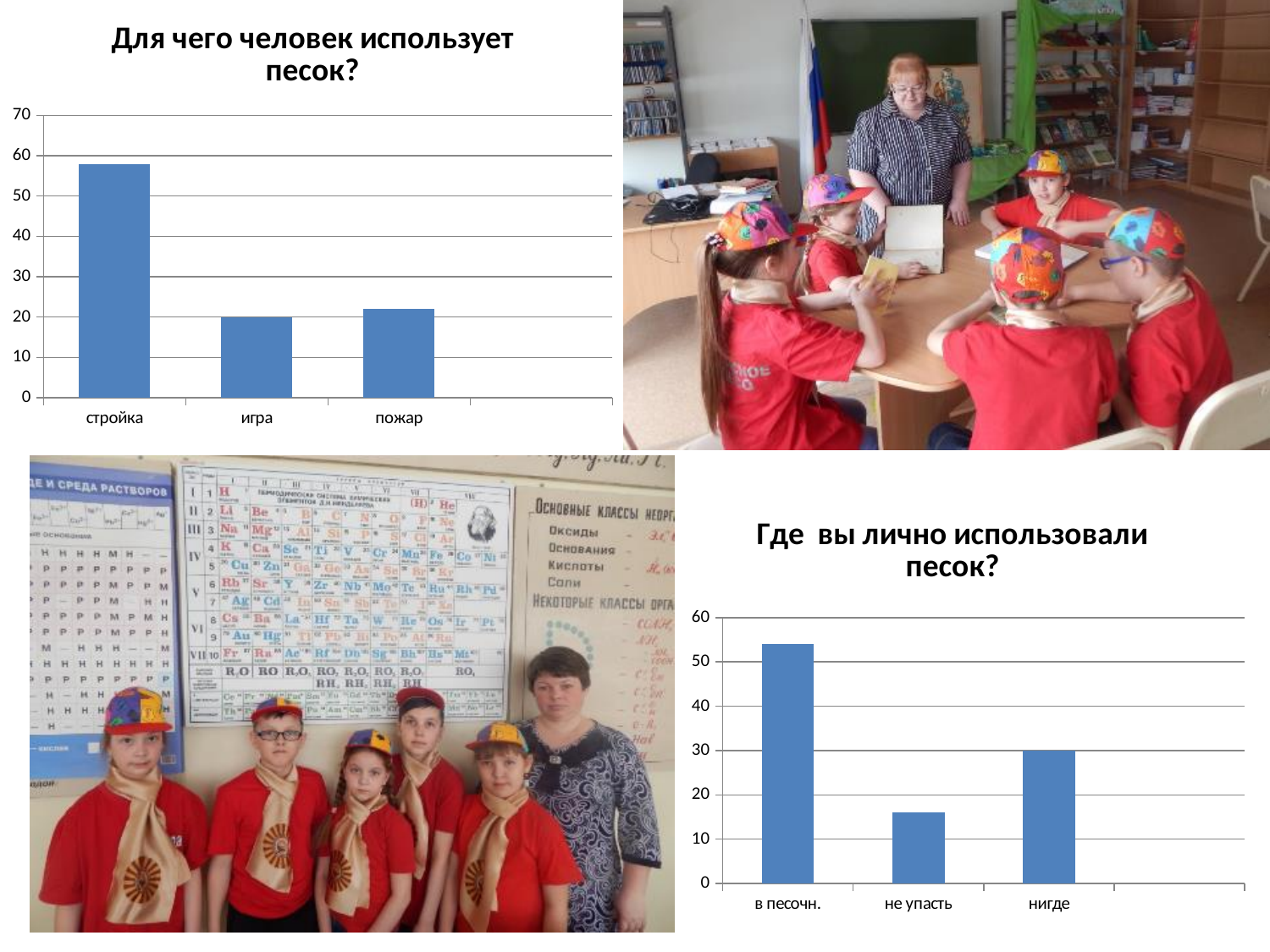
In the chart 'Где вы лично использовали песок?', is the value for не упасть greater or less than 20? less In the chart 'Для чего человек использует песок?', is the value for пожар greater or less than 30? less In the chart 'Где вы лично использовали песок?', which category has the lowest value? не упасть In the chart 'Для чего человек использует песок?', is the value for стройка greater or less than 50? greater In the chart 'Для чего человек использует песок?', which category has the lowest value? игра In the chart 'Где вы лично использовали песок?', which category has the highest value? в песочн. In the chart 'Где вы лично использовали песок?', which is larger: the value for нигде or the value for не упасть? нигде In the chart 'Для чего человек использует песок?', which category has the highest value? стройка How many categories are shown in the chart 'Где вы лично использовали песок?'? 3 What type of chart is 'Для чего человек использует песок?'? bar chart How many categories are shown in the chart 'Для чего человек использует песок?'? 3